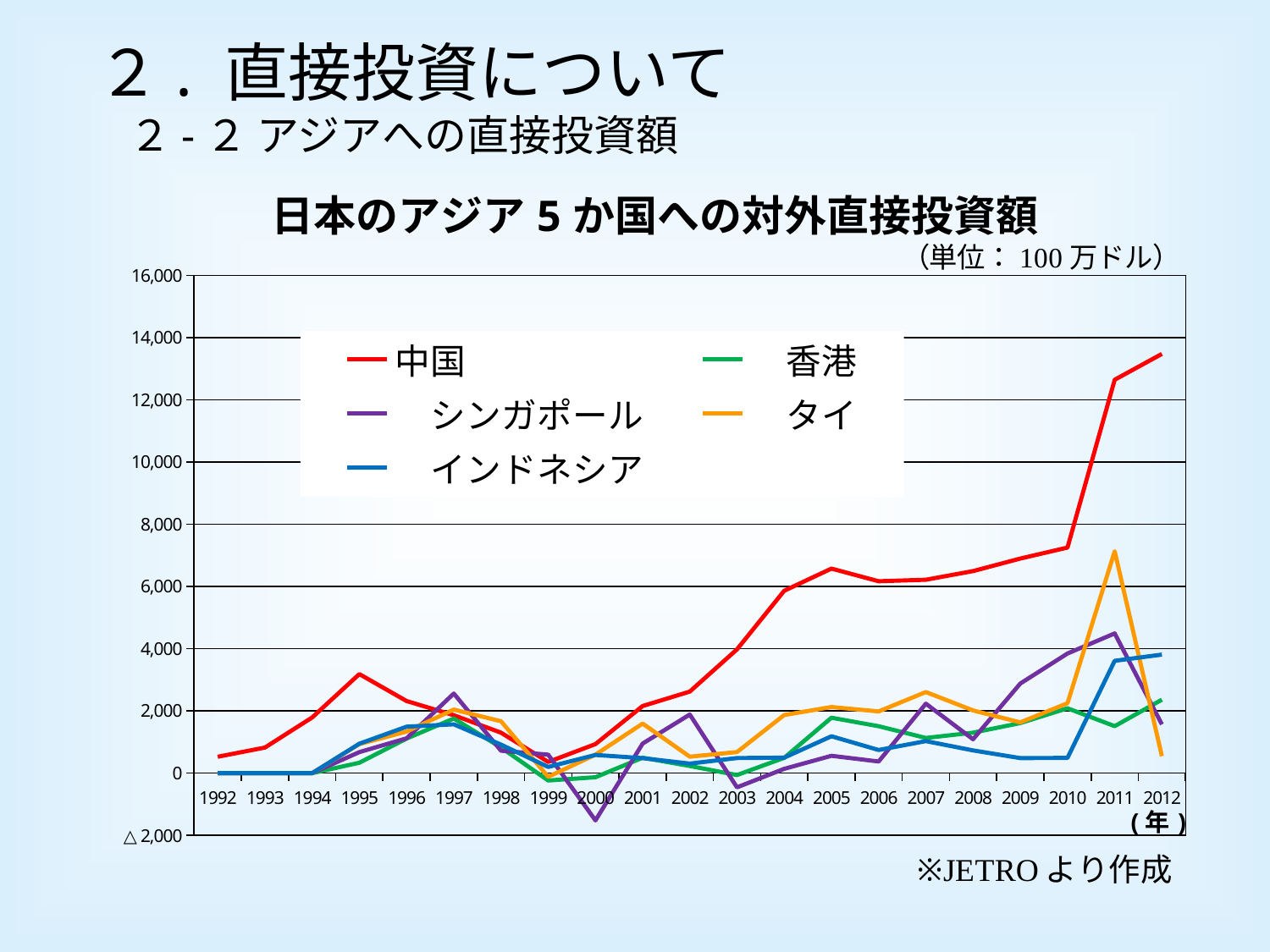
What kind of chart is shown on the slide? line chart Is the value for シンガポール in 2000 greater or less than 0? less What unit is stated for the values in the chart? 100万ドル Does the value for 中国 generally rise or fall from 2007 to 2012? rise Is the value for 中国 in 2012 greater or less than 12,000? greater How many series does the legend list? 5 In 2011, which is larger: the value for タイ or the value for シンガポール? タイ How many years are plotted along the x axis? 21 Is the value for 中国 in 1995 greater or less than 2,000? greater Which series has the lowest value in 2000? シンガポール Which series has the highest value in 2012? 中国